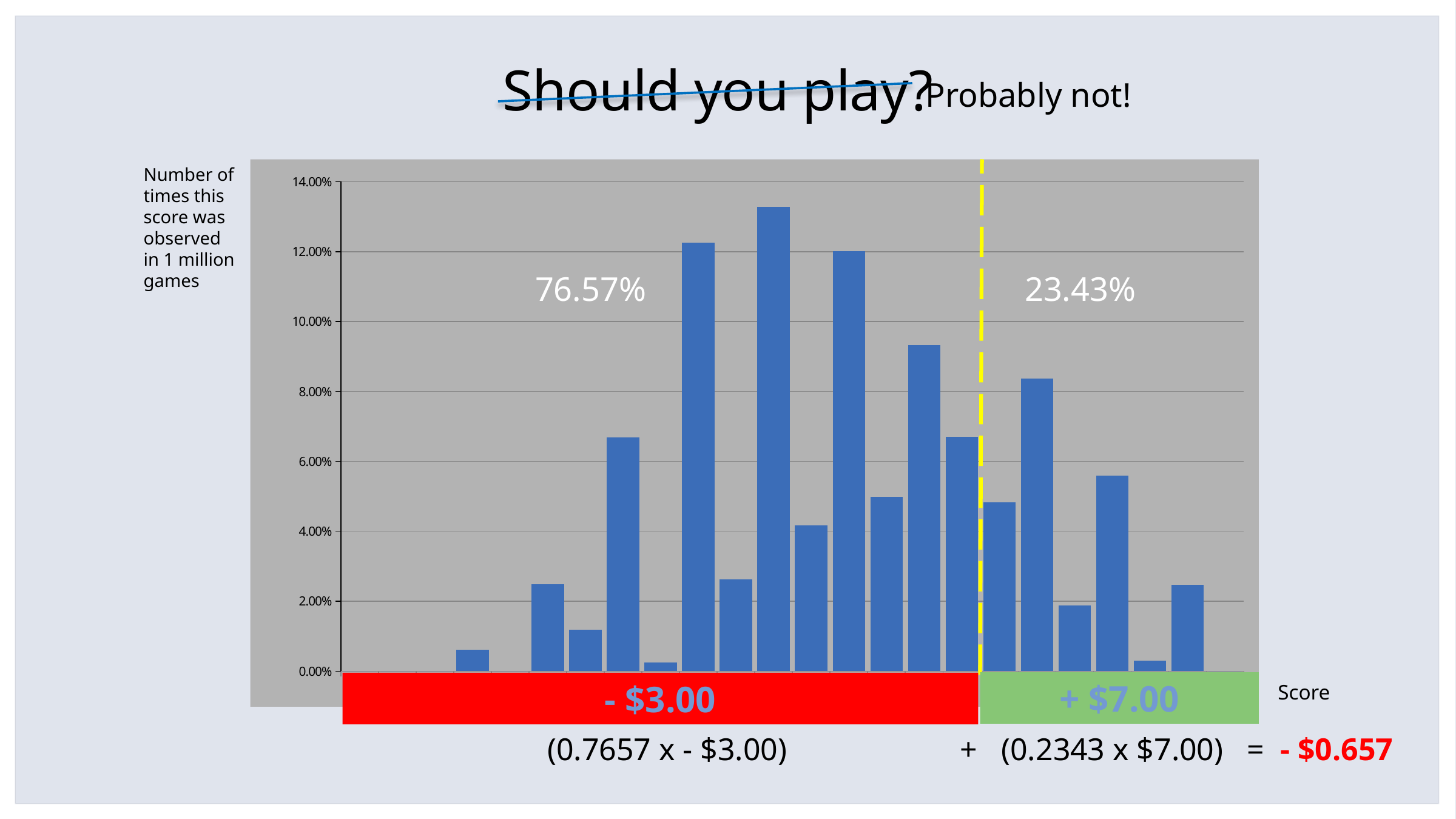
What expected value is printed in red at the bottom right of the slide? - $0.657 What percentage is printed on the right (green, + $7.00) side of the dashed line? 23.43% Is the value of the tallest bar greater or less than 12.00%? greater Which side of the dashed line has the larger printed percentage, the - $3.00 side or the + $7.00 side? the - $3.00 side Is the value of the tallest bar greater or less than 14.00%? less What colour is the dashed vertical line that splits the chart? yellow What payout is printed in the green band below the chart? + $7.00 What payout is printed in the red band below the chart? - $3.00 What percentage is printed on the left (red, - $3.00) side of the dashed line? 76.57% What kind of chart is shown on the slide? bar chart What is the difference between the two printed percentages, 76.57% and 23.43%? 53.14% What is the highest tick value shown on the vertical axis? 14.00%